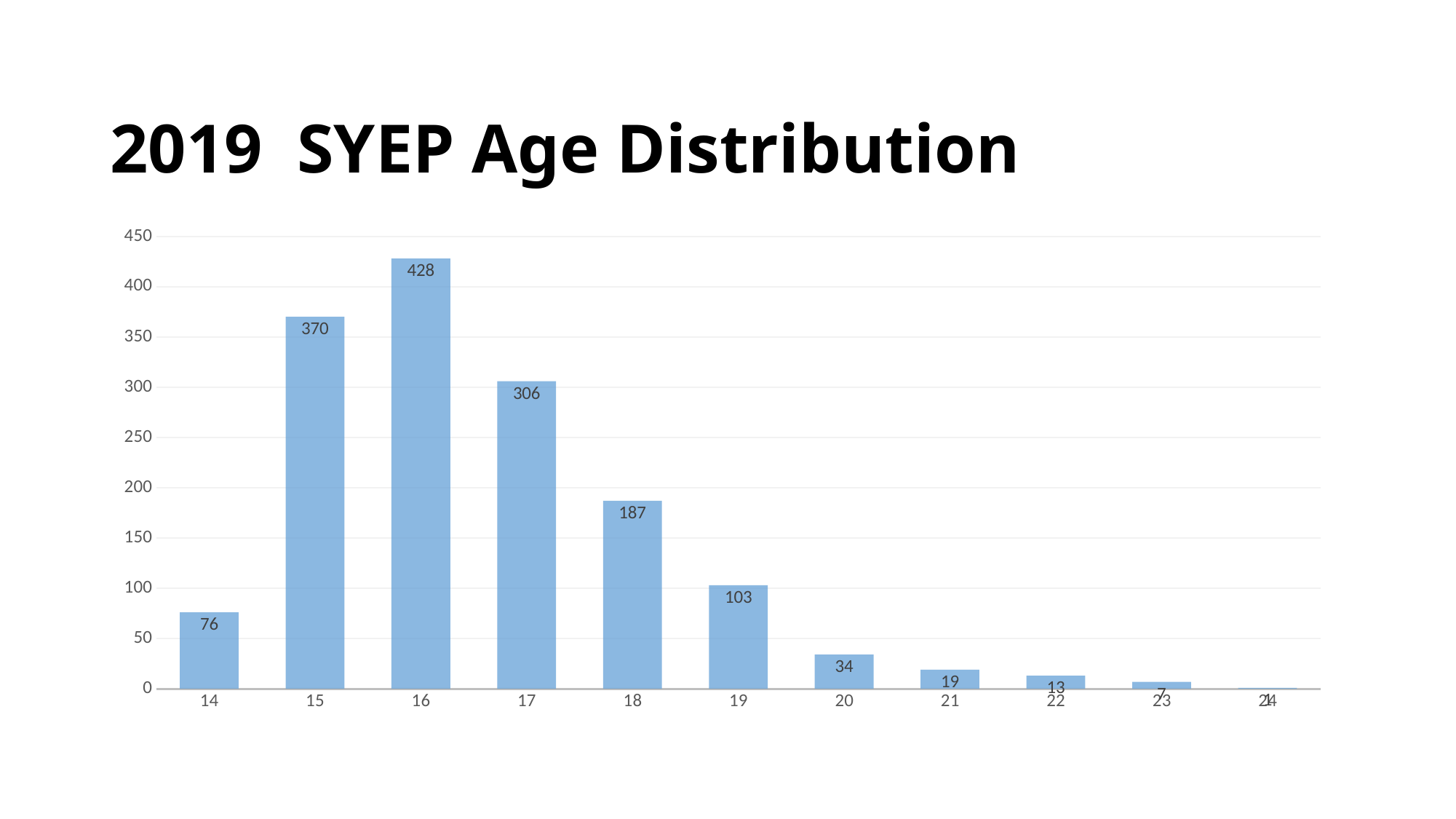
What is the value for age 16? 428 Is the value for age 17 greater or less than 300? greater What is the value for age 18? 187 What is the value for age 20? 34 What is the difference between the values for age 21 and age 22? 6 What is the title of the slide? 2019 SYEP Age Distribution What is the difference between the values for age 15 and age 17? 64 Which age has the highest value? 16 Which is larger, the value for age 14 or the value for age 19? age 19 What kind of chart is shown on the slide? bar chart Do the values rise or fall from age 16 to age 23? fall How many age categories are shown on the x axis? 11